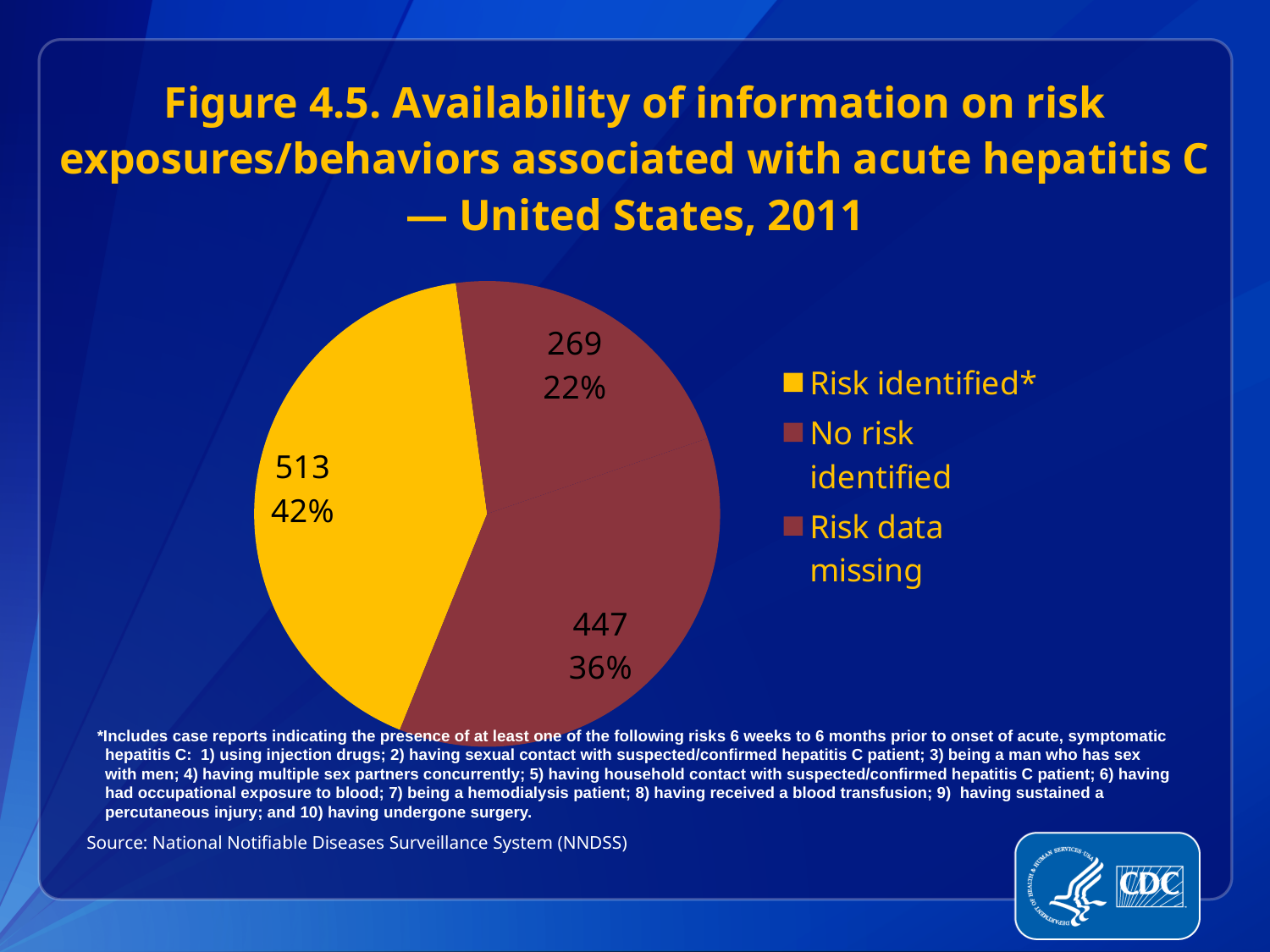
What is the difference between the 'Risk identified*' value (513) and the slice labeled 447? 66 What colour is the 'Risk identified*' slice? yellow Which category has the largest slice of the pie? Risk identified* What is the smallest value shown on any slice of the pie? 269 What type of chart is shown on the slide? pie chart Which is larger: the 'Risk identified*' slice or the slice labeled 36%? Risk identified* What is the number of cases in the 'Risk identified*' slice? 513 How many entries does the legend list? 3 What is the total of the three values shown on the pie chart? 1229 What percentage is shown on the slice labeled 269? 22% What percentage of the pie does the 'Risk identified*' slice represent? 42% How many slices does the pie chart have? 3